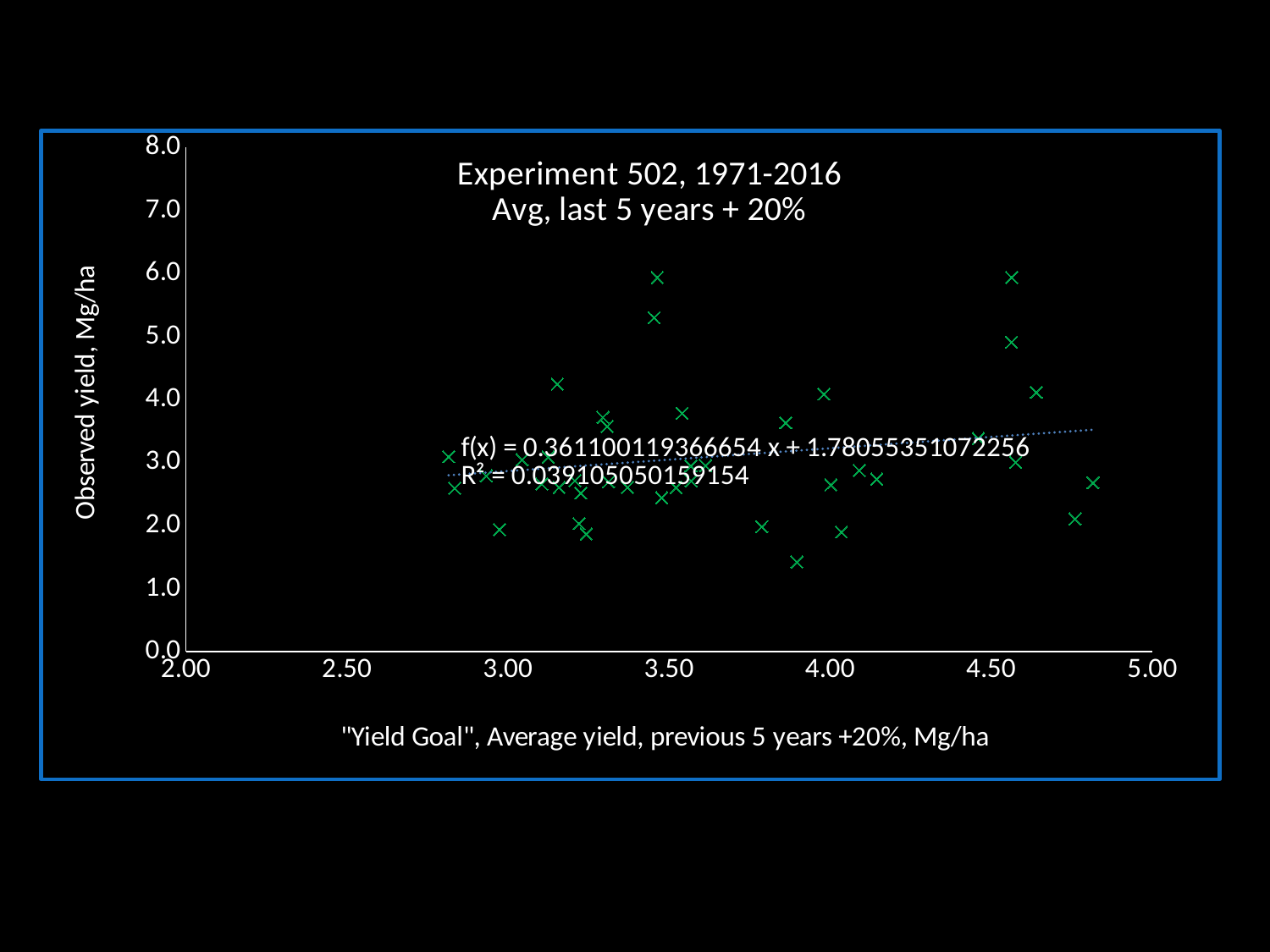
What is the intercept of the trendline equation printed on the chart? 1.78055351072256 What kind of chart is shown on the slide? scatter chart What is the slope of the trendline equation printed on the chart? 0.361100119366654 What is the title of the chart? Experiment 502, 1971-2016 Avg, last 5 years + 20% Is the highest observed yield plotted on the chart greater or less than 5.0? greater What is the label of the vertical axis? Observed yield, Mg/ha What R² value is printed on the chart? 0.039105050159154 Is the R² value printed on the chart greater or less than 0.1? less What is the lowest value shown on the horizontal axis? 2.00 Does the trendline rise or fall as the yield goal increases along the x axis? rises Is the lowest observed yield plotted on the chart greater or less than 2.0? less What is the highest value shown on the vertical axis? 8.0